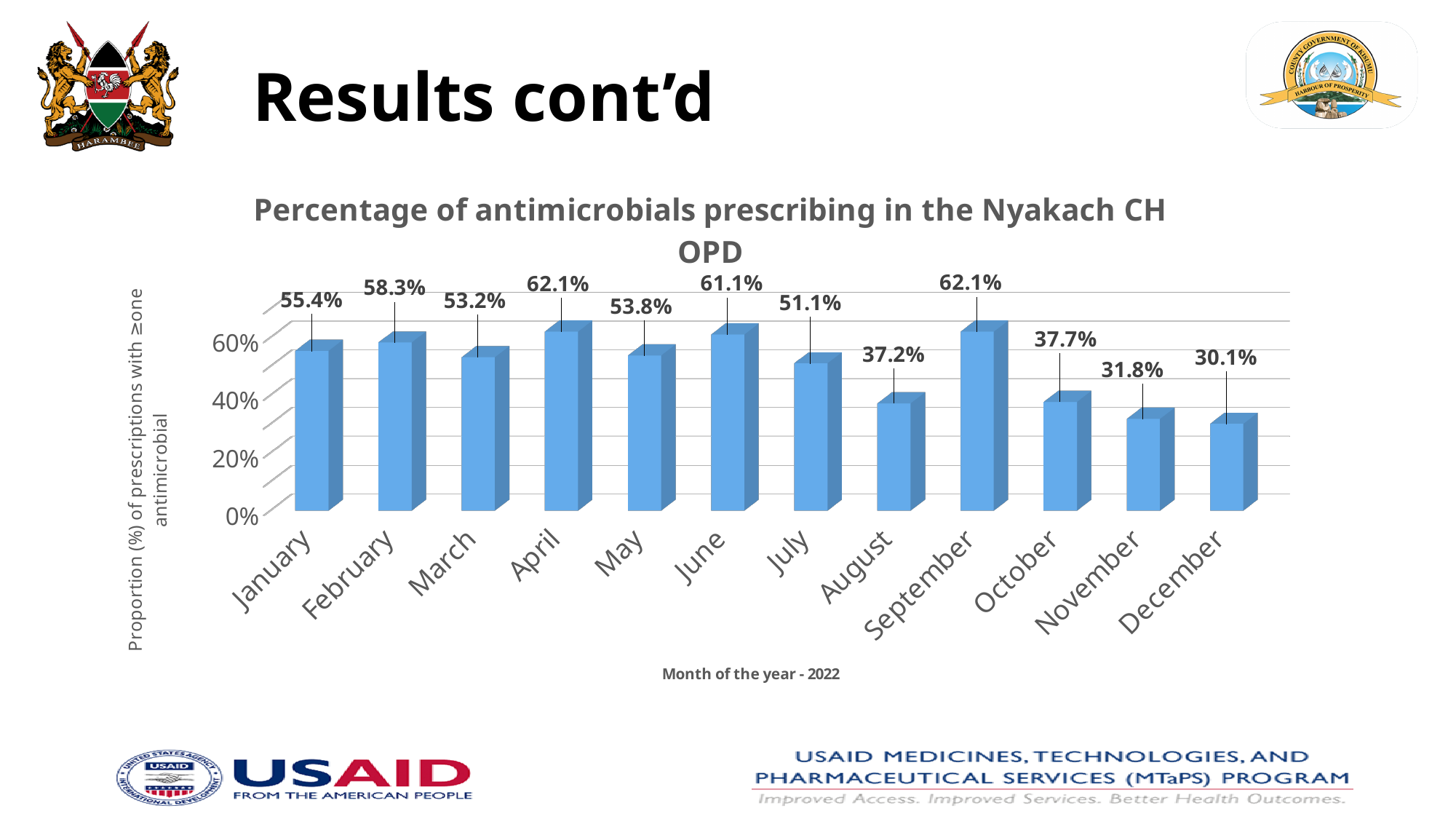
What kind of chart is shown? Bar chart What is the value for April? 62.1% Which months share the highest value? April and September What is the value for December? 30.1% What is the x-axis label of the chart? Month of the year - 2022 What is the value for August? 37.2% What is the difference between the values for June and July? 10.0% Which month has the lowest value? December Is the value for March greater or less than 40%? greater How many months are shown on the x axis? 12 Which is larger, the value for October or the value for November? October What is the value for February? 58.3%